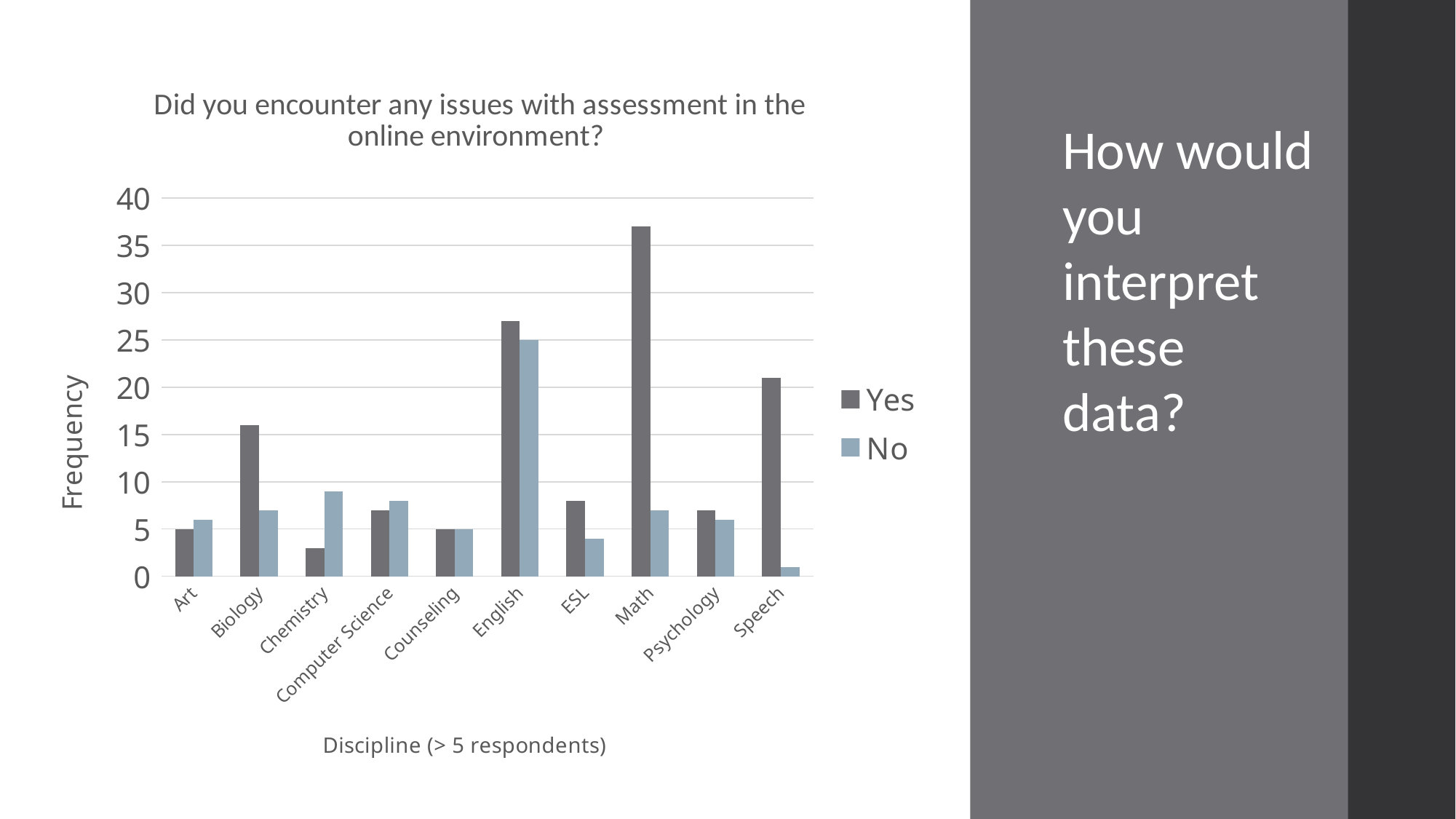
What kind of chart is shown on the slide? bar chart Which discipline has the highest 'Yes' value? Math Which discipline has the lowest 'No' value? Speech How many disciplines are shown on the x axis? 10 For Biology, which is larger, the 'Yes' value or the 'No' value? Yes How many series does the legend list? 2 What is the label of the y axis? Frequency Is the 'Yes' value for Math greater or less than 35? greater Which discipline has the highest 'No' value? English Which discipline has the lowest 'Yes' value? Chemistry